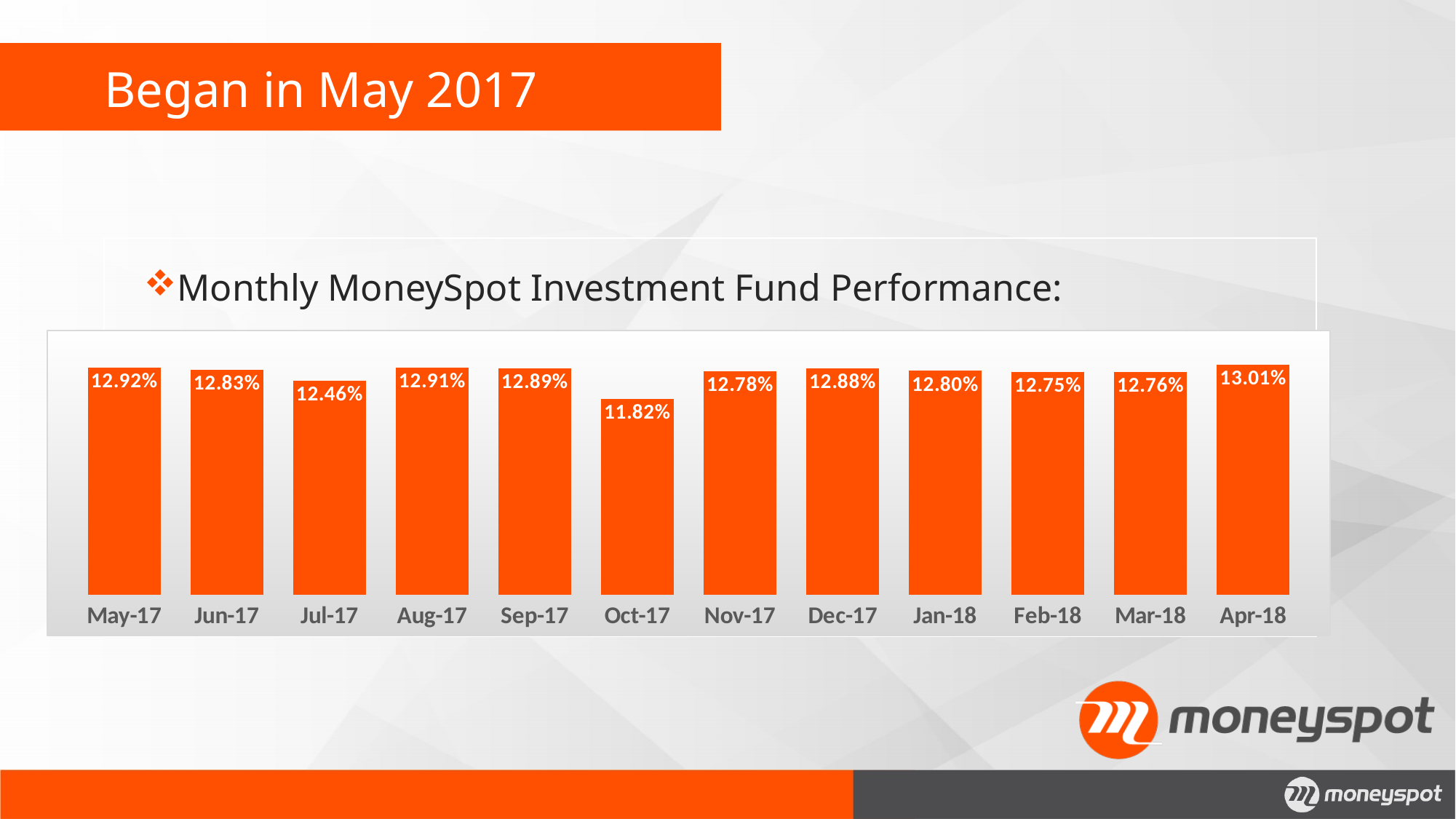
What is the value for Jul-17? 12.46% Which month has the lowest value? Oct-17 What is the difference between the values for May-17 and Jul-17? 0.46% What is the difference between the values for Apr-18 and Oct-17? 1.19% What colour are the bars in the chart? Orange What is the value for Oct-17? 11.82% Which month has the highest value? Apr-18 How many months are shown in the chart? 12 Which is larger, the value for Jul-17 or the value for Aug-17? Aug-17 What is the value for Dec-17? 12.88% What kind of chart is shown on the slide? Bar chart What is the value for Apr-18? 13.01%